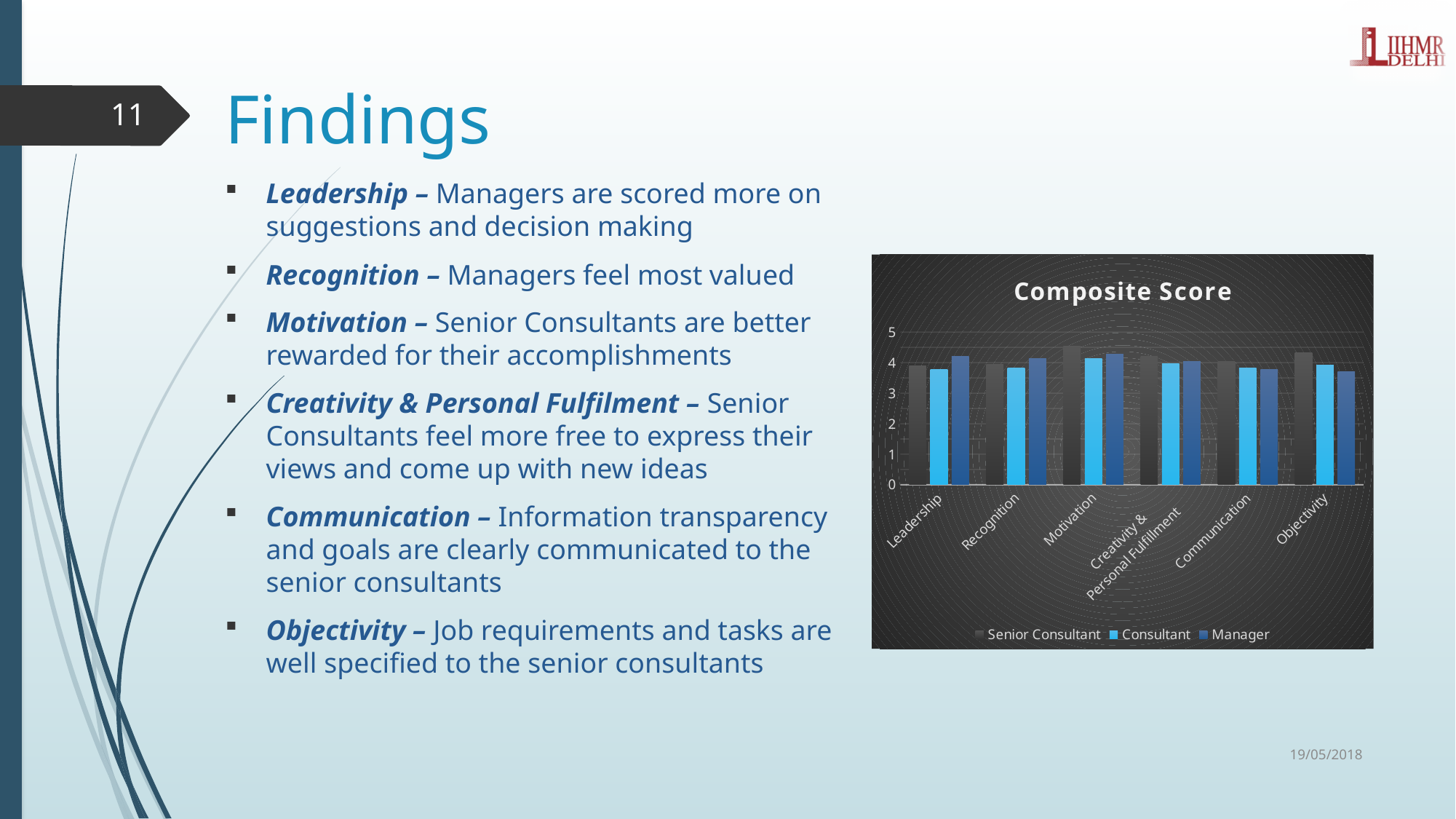
Is the Senior Consultant value for Motivation greater or less than 4? greater Which series are listed in the chart legend? Senior Consultant, Consultant, Manager For Objectivity, which is larger: the Senior Consultant value or the Manager value? Senior Consultant For Leadership, which is larger: the Manager value or the Consultant value? Manager For which category is the Senior Consultant value highest? Motivation Is the Manager value for Leadership greater or less than 3? greater What is the title of the chart? Composite Score What type of chart is shown on the slide? Bar chart Is the Consultant value for Leadership greater or less than 4? less How many categories are shown on the x axis of the chart? 6 How many series does the chart legend list? 3